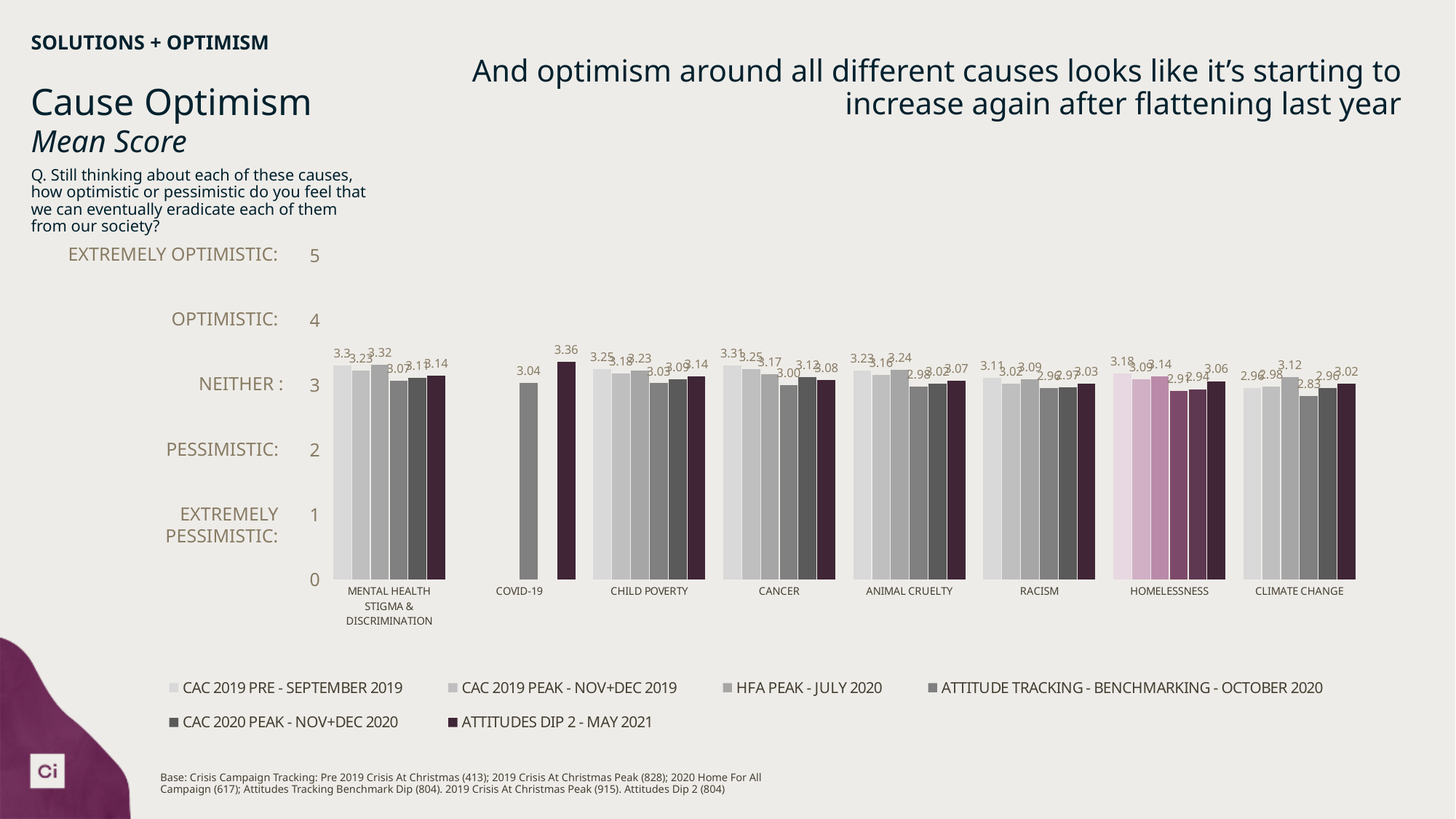
Which cause has the highest mean score shown on the chart? COVID-19 What is the mean score for Homelessness in the CAC 2019 Pre - September 2019 series? 3.18 How many bars are plotted for the COVID-19 category? 2 Which cause has the lowest mean score shown on the chart? Climate Change How many series does the chart's legend list? 6 What is the mean score for COVID-19 in the Attitudes Dip 2 - May 2021 series? 3.36 Is the Climate Change score for Attitude Tracking - Benchmarking - October 2020 greater or less than 3? less In the HFA Peak - July 2020 series, which has the higher mean score: Mental Health Stigma & Discrimination or Climate Change? Mental Health Stigma & Discrimination How many causes (categories) are shown along the x axis of the chart? 8 What kind of chart is shown on the slide? bar chart